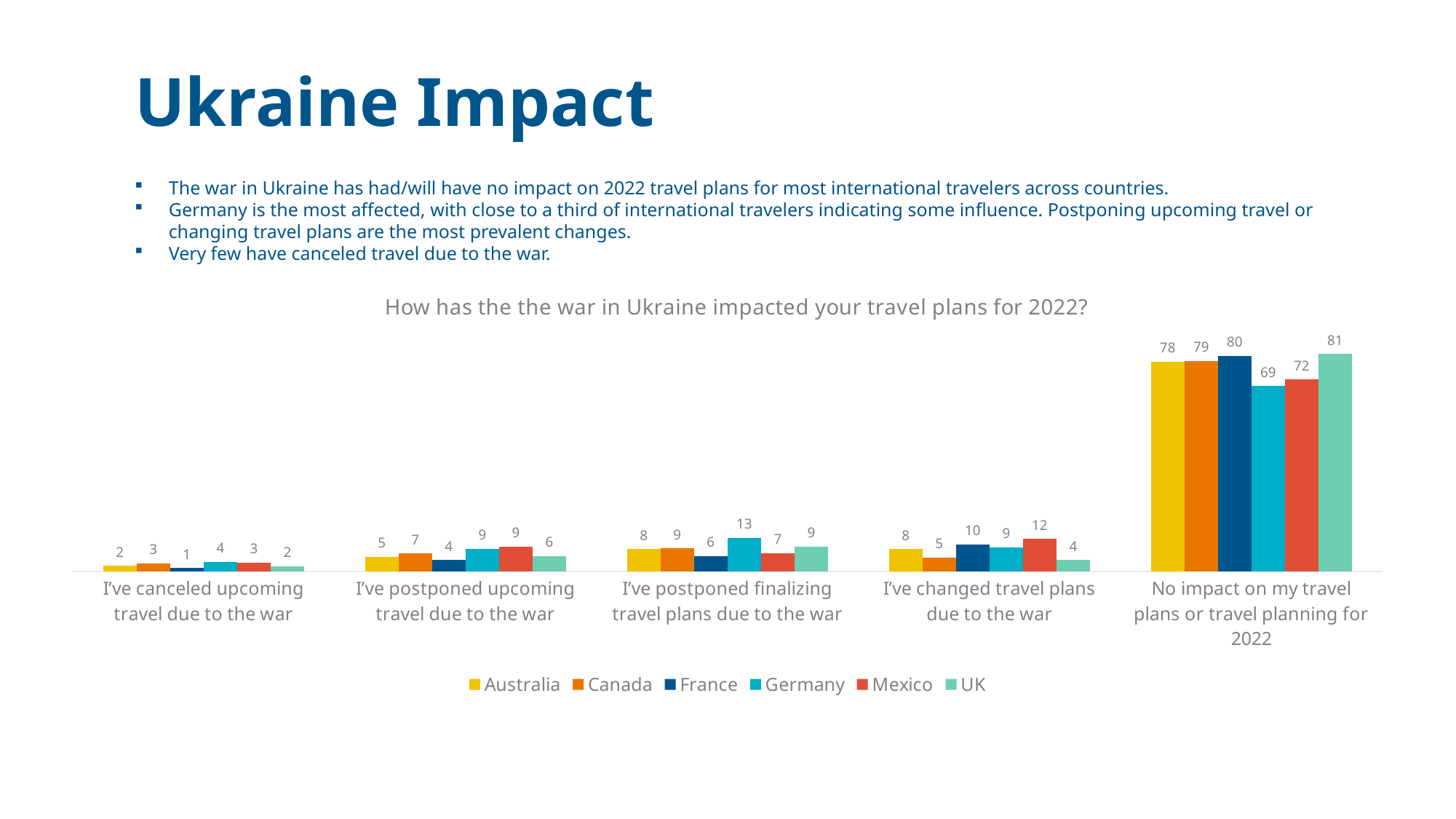
Which country has the highest value in the 'No impact on my travel plans or travel planning for 2022' category? UK What is the value for Mexico in the 'I've changed travel plans due to the war' category? 12 What kind of chart is shown on the slide? Bar chart Which country has the lowest value in the 'I've canceled upcoming travel due to the war' category? France In the 'I've changed travel plans due to the war' category, which is larger: the value for Australia or the value for Canada? Australia What is the value for Germany in the 'No impact on my travel plans or travel planning for 2022' category? 69 How many response categories are shown on the x axis? 5 What is the difference between the UK and Germany values in the 'No impact on my travel plans or travel planning for 2022' category? 12 How many series does the legend list? 6 What is the value for Germany in the 'I've postponed finalizing travel plans due to the war' category? 13 Which country is represented by the dark blue bars in the legend? France What is the title of the chart? How has the the war in Ukraine impacted your travel plans for 2022?